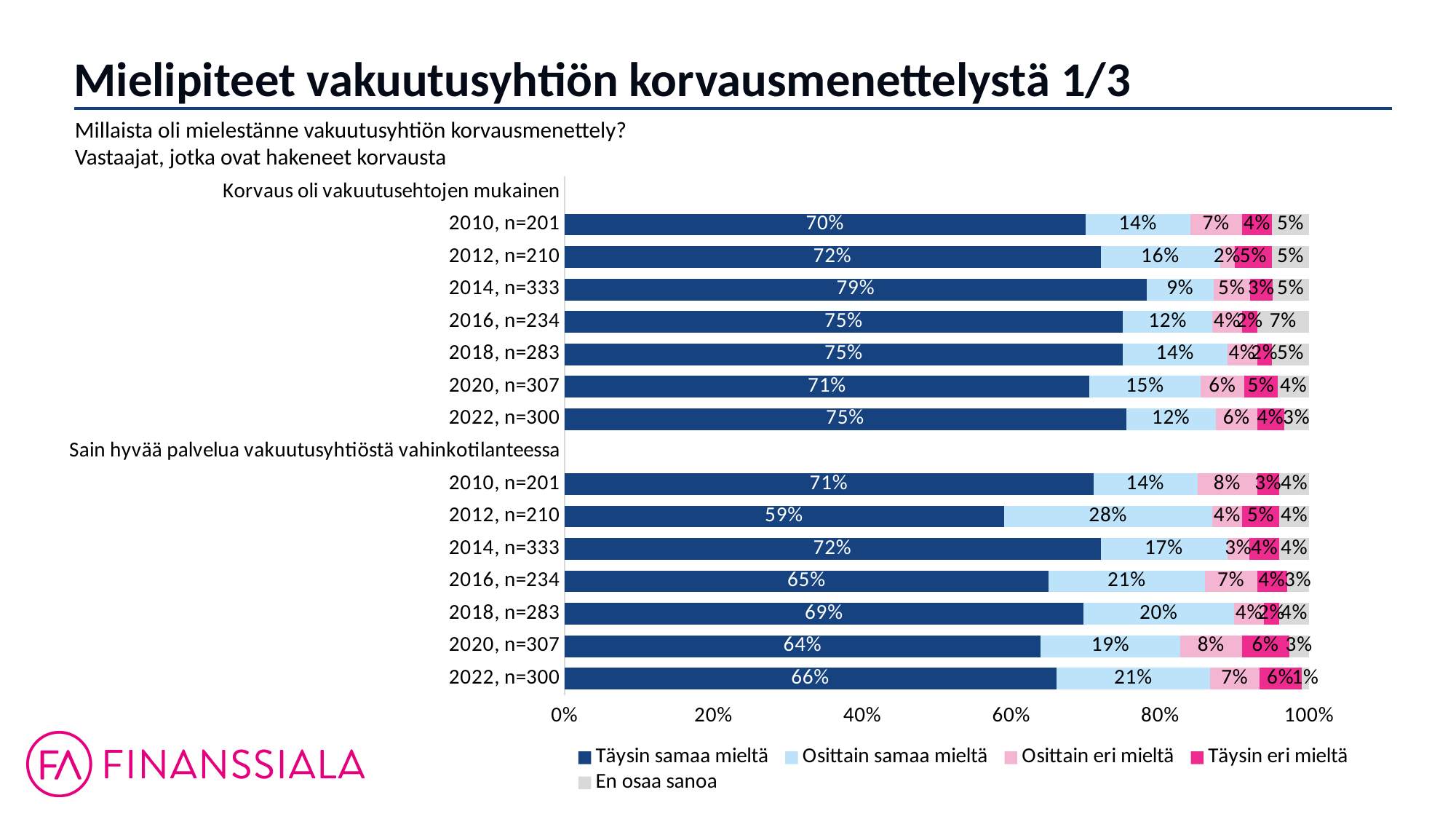
What kind of chart is shown on the slide? Stacked bar chart Is the 'Täysin samaa mieltä' value for 2012, n=210 under 'Sain hyvää palvelua vakuutusyhtiöstä vahinkotilanteessa' greater or less than 60%? less How many series does the legend list? 5 What is the 'En osaa sanoa' value for 2022, n=300 under 'Sain hyvää palvelua vakuutusyhtiöstä vahinkotilanteessa'? 1% What is the difference between the 'Täysin samaa mieltä' values for 2014, n=333 and 2010, n=201 under 'Korvaus oli vakuutusehtojen mukainen'? 9 percentage points What is the 'Osittain samaa mieltä' value for 2012, n=210 under 'Sain hyvää palvelua vakuutusyhtiöstä vahinkotilanteessa'? 28% What is the 'Täysin samaa mieltä' value for 2014, n=333 under 'Korvaus oli vakuutusehtojen mukainen'? 79% Under 'Sain hyvää palvelua vakuutusyhtiöstä vahinkotilanteessa', is the 'Täysin samaa mieltä' value larger for 2018, n=283 or 2020, n=307? 2018, n=283 What is the last legend entry in the chart? En osaa sanoa Which year has the lowest 'Täysin samaa mieltä' share under 'Sain hyvää palvelua vakuutusyhtiöstä vahinkotilanteessa'? 2012, n=210 How many bars are plotted in the chart in total? 14 Which year has the highest 'Täysin samaa mieltä' share under 'Korvaus oli vakuutusehtojen mukainen'? 2014, n=333